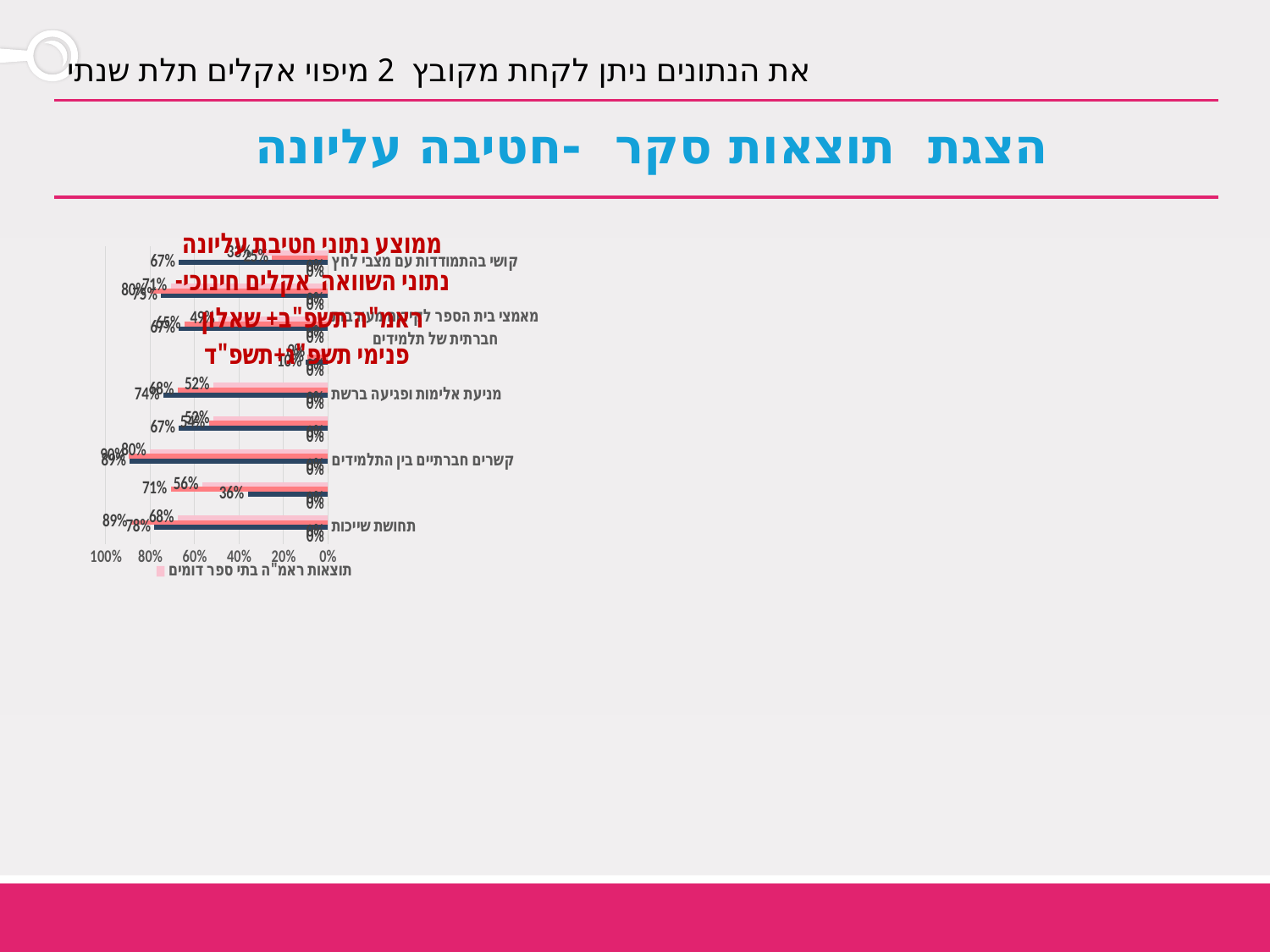
Which category has a longer longest bar: "תחושת שייכות" or "קושי בהתמודדות עם מצבי לחץ"? תחושת שייכות What kind of chart is shown on the slide? bar chart Is the longest bar for "קושי בהתמודדות עם מצבי לחץ" greater or less than 60%? greater Is the longest bar for "קושי בהתמודדות עם מצבי לחץ" greater or less than 80%? less What is the highest value shown on the x axis of the chart? 100% Is the longest bar for "תחושת שייכות" greater or less than 80%? greater What series name is shown in the chart's legend? תוצאות ראמ"ה בתי ספר דומים